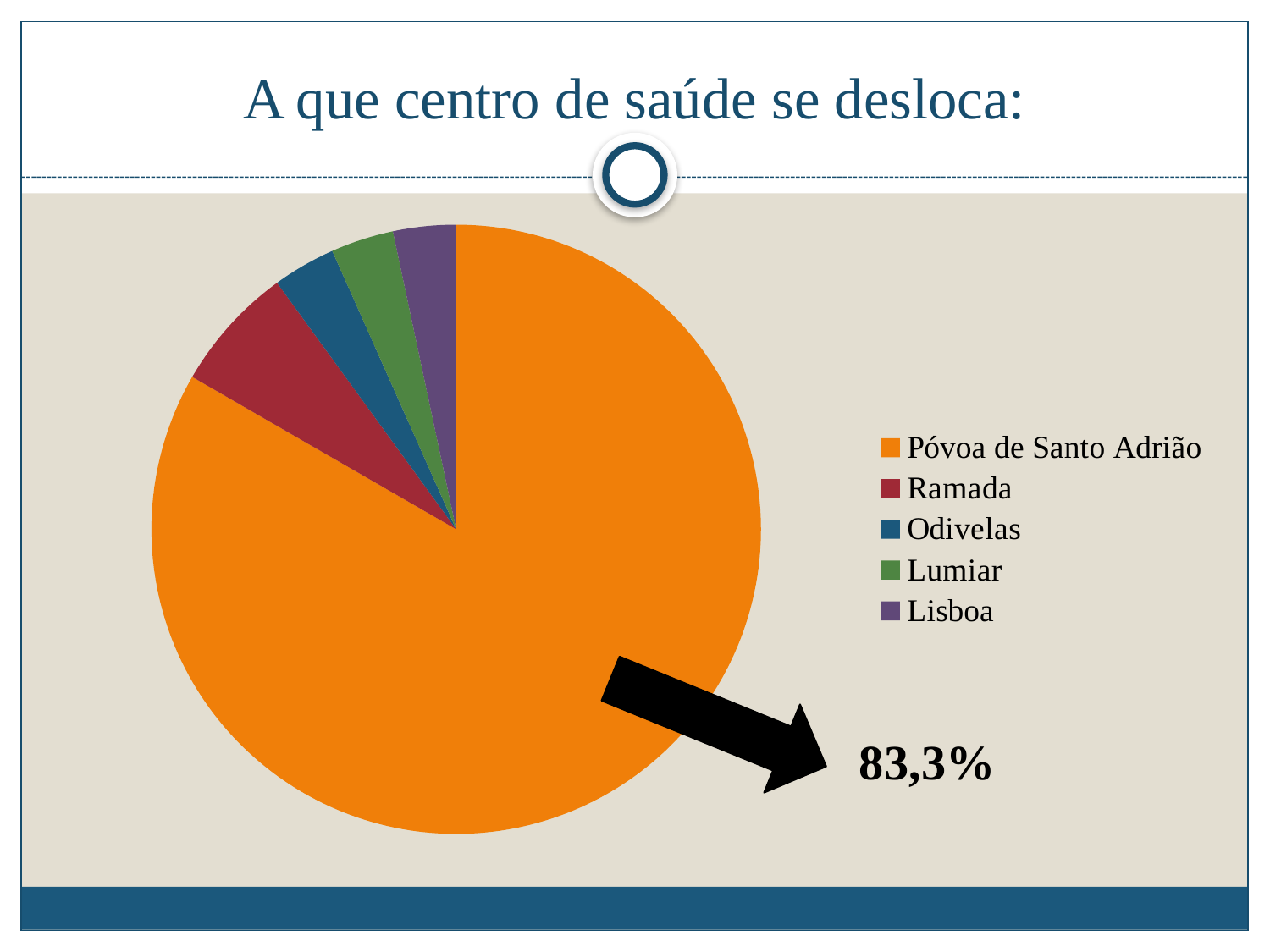
What share of the pie does Póvoa de Santo Adrião represent? 83,3% What is the title of the slide containing the pie chart? A que centro de saúde se desloca: What percentage is indicated by the arrow pointing at the orange slice? 83,3% Which health centre has the largest slice of the pie chart? Póvoa de Santo Adrião Which colour represents Lisboa in the pie chart? purple How many entries does the legend of the pie chart list? 5 How many categories (slices) does the pie chart have? 5 What kind of chart is shown on the slide? pie chart Which slice is larger, Póvoa de Santo Adrião or Ramada? Póvoa de Santo Adrião Which slice is larger, Ramada or Odivelas? Ramada Which health centre has the second largest slice of the pie chart? Ramada